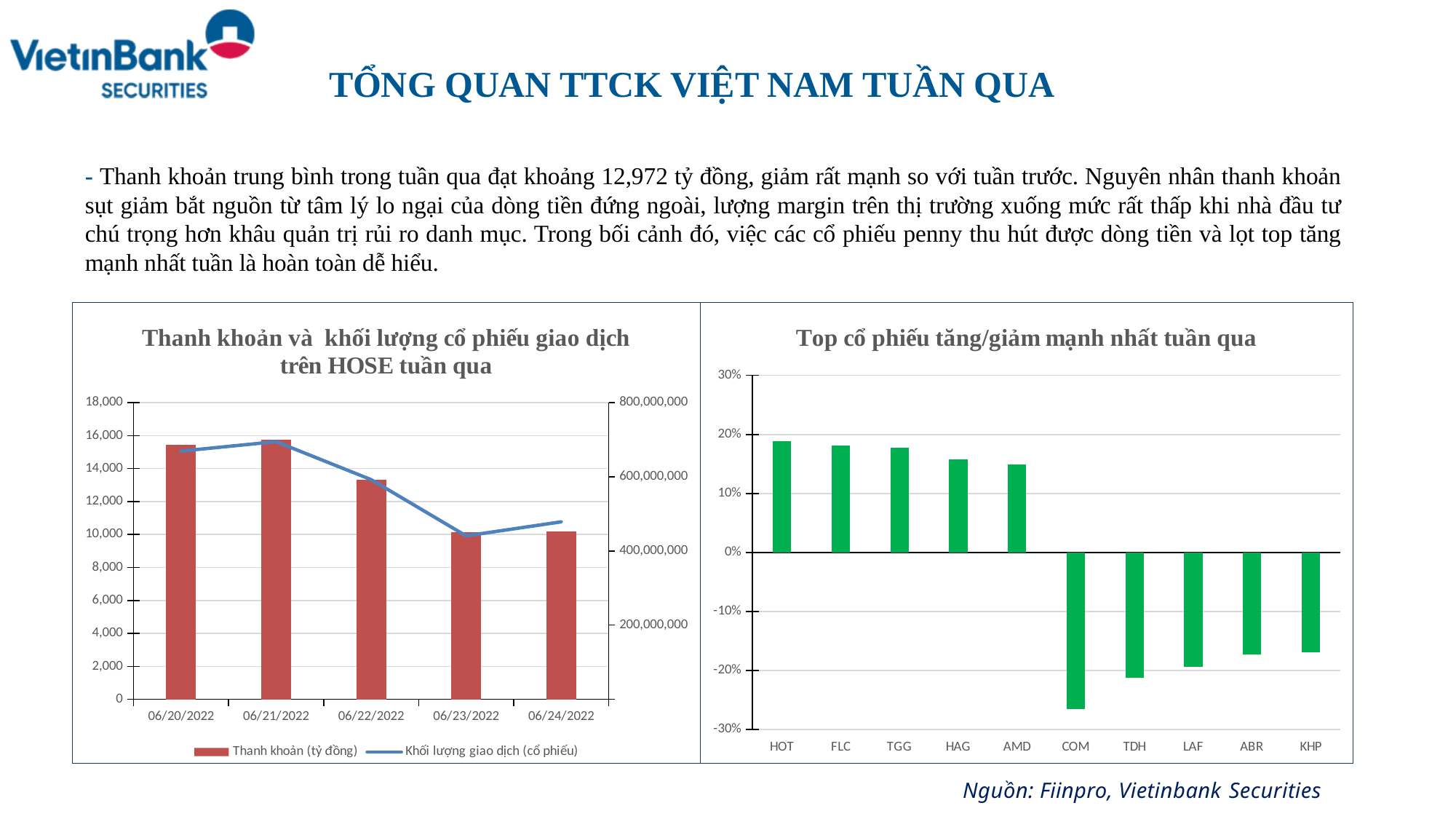
In the chart 'Top cổ phiếu tăng/giảm mạnh nhất tuần qua', is the value for HOT greater or less than 10%? greater In the chart 'Top cổ phiếu tăng/giảm mạnh nhất tuần qua', how many stocks are shown on the x axis? 10 In the chart 'Thanh khoản và khối lượng cổ phiếu giao dịch trên HOSE tuần qua', how many series does the legend list? 2 In the chart 'Thanh khoản và khối lượng cổ phiếu giao dịch trên HOSE tuần qua', is the Thanh khoản (tỷ đồng) bar for 06/23/2022 greater or less than 12,000? less In the chart 'Thanh khoản và khối lượng cổ phiếu giao dịch trên HOSE tuần qua', is the Thanh khoản (tỷ đồng) bar for 06/20/2022 larger or smaller than the bar for 06/22/2022? larger What kind of chart is 'Top cổ phiếu tăng/giảm mạnh nhất tuần qua'? bar chart In the chart 'Thanh khoản và khối lượng cổ phiếu giao dịch trên HOSE tuần qua', which date has the highest Thanh khoản (tỷ đồng) bar? 06/21/2022 In the chart 'Thanh khoản và khối lượng cổ phiếu giao dịch trên HOSE tuần qua', is the Thanh khoản (tỷ đồng) bar for 06/22/2022 greater or less than 12,000? greater In the chart 'Top cổ phiếu tăng/giảm mạnh nhất tuần qua', which stock has the lowest value? COM In the chart 'Thanh khoản và khối lượng cổ phiếu giao dịch trên HOSE tuần qua', how many dates are shown on the x axis? 5 In the chart 'Thanh khoản và khối lượng cổ phiếu giao dịch trên HOSE tuần qua', does the Khối lượng giao dịch (cổ phiếu) line generally rise or fall from 06/21/2022 to 06/23/2022? fall